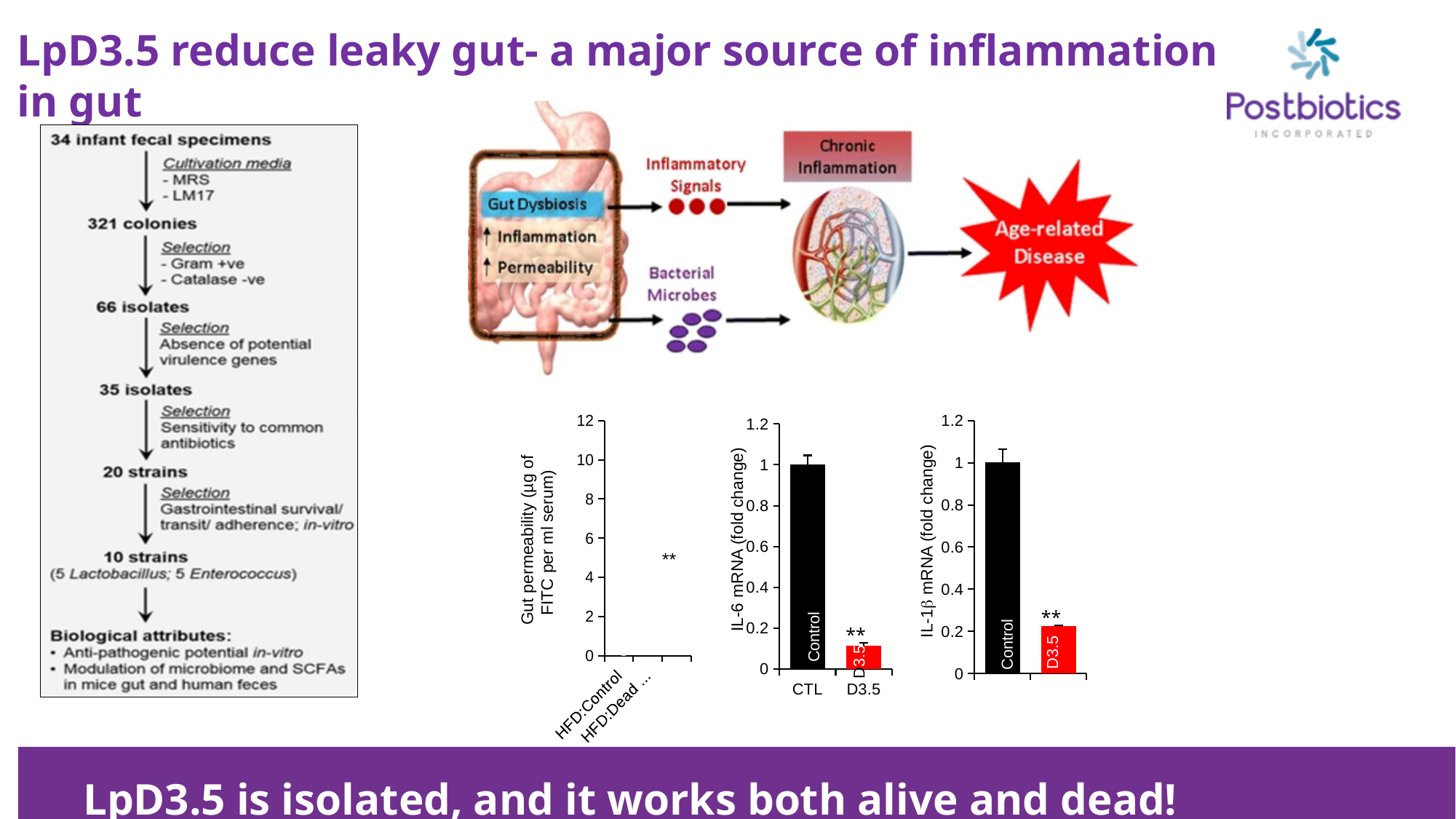
In the IL-6 mRNA chart, is the value for CTL greater or less than 0.8? greater In the IL-1β mRNA chart, which category has the lowest value? D3.5 What is the y-axis label of the leftmost chart? Gut permeability (µg of FITC per ml serum) In the IL-6 mRNA chart, is the value for D3.5 greater or less than 0.2? less In the IL-1β mRNA chart, is the value for D3.5 greater or less than 0.4? less How many categories are shown on the x axis of the IL-1β mRNA chart? 2 In the IL-6 mRNA chart, which category has the higher value, CTL or D3.5? CTL What is the maximum value shown on the y axis of the gut permeability chart? 12 How many categories are shown on the x axis of the gut permeability chart? 2 What kind of chart is the IL-6 mRNA chart? bar chart In the IL-6 mRNA chart, what colour is the D3.5 bar? red